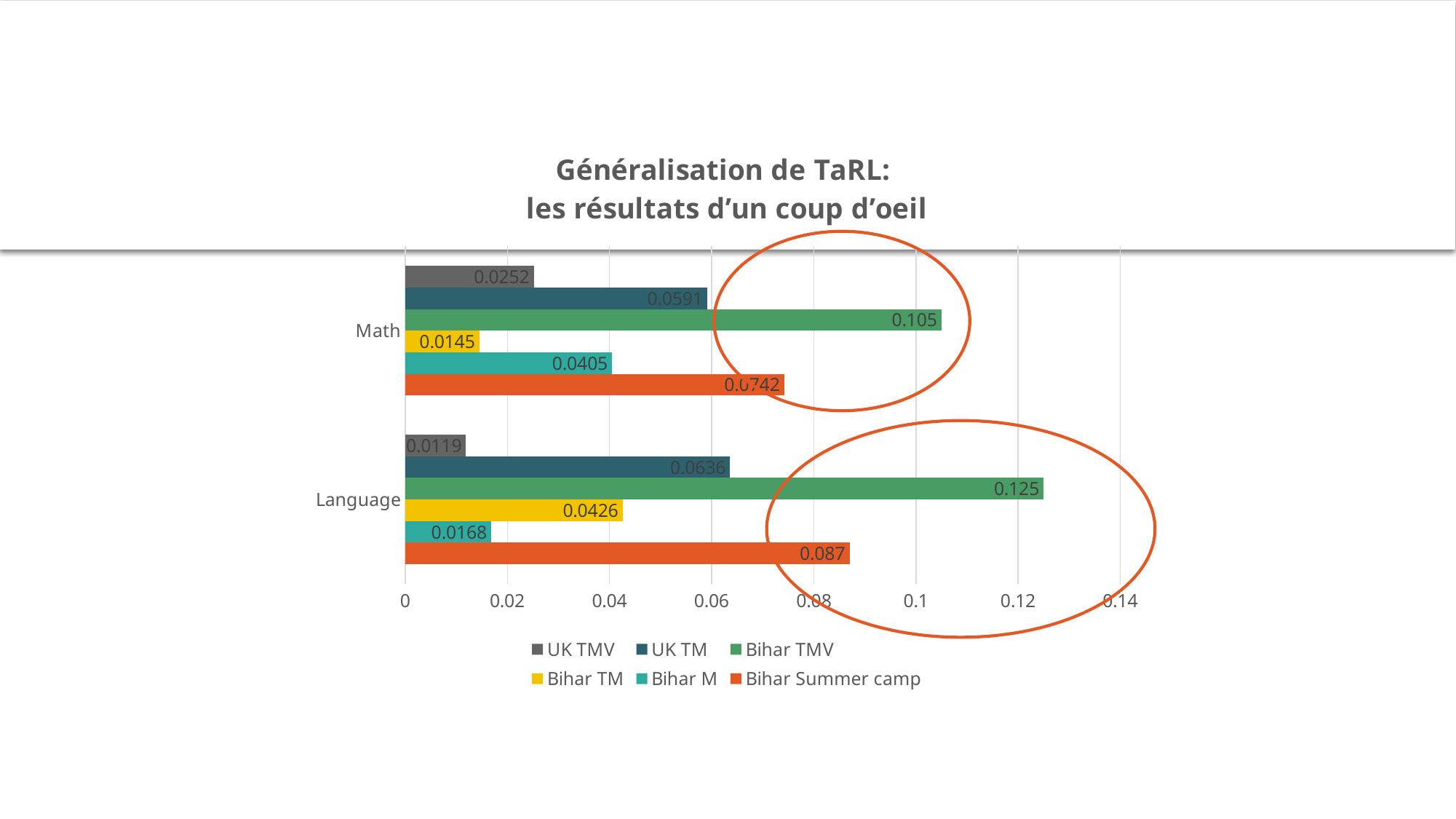
Which series has the lowest value in the Math category? Bihar TM Which series has the highest value in the Language category? Bihar TMV What is the difference between the Bihar TMV values for Language and Math? 0.02 How many series does the legend list? 6 How many categories are shown on the vertical axis? 2 Which is larger: UK TM for Math or Bihar Summer camp for Math? Bihar Summer camp for Math What is the value for UK TM in the Language category? 0.0636 What is the value for Bihar TMV in the Math category? 0.105 What is the value for Bihar TM in the Math category? 0.0145 What kind of chart is shown on the slide? Bar chart What is the value for Bihar Summer camp in the Language category? 0.087 What is the title of the chart? Généralisation de TaRL: les résultats d'un coup d'oeil